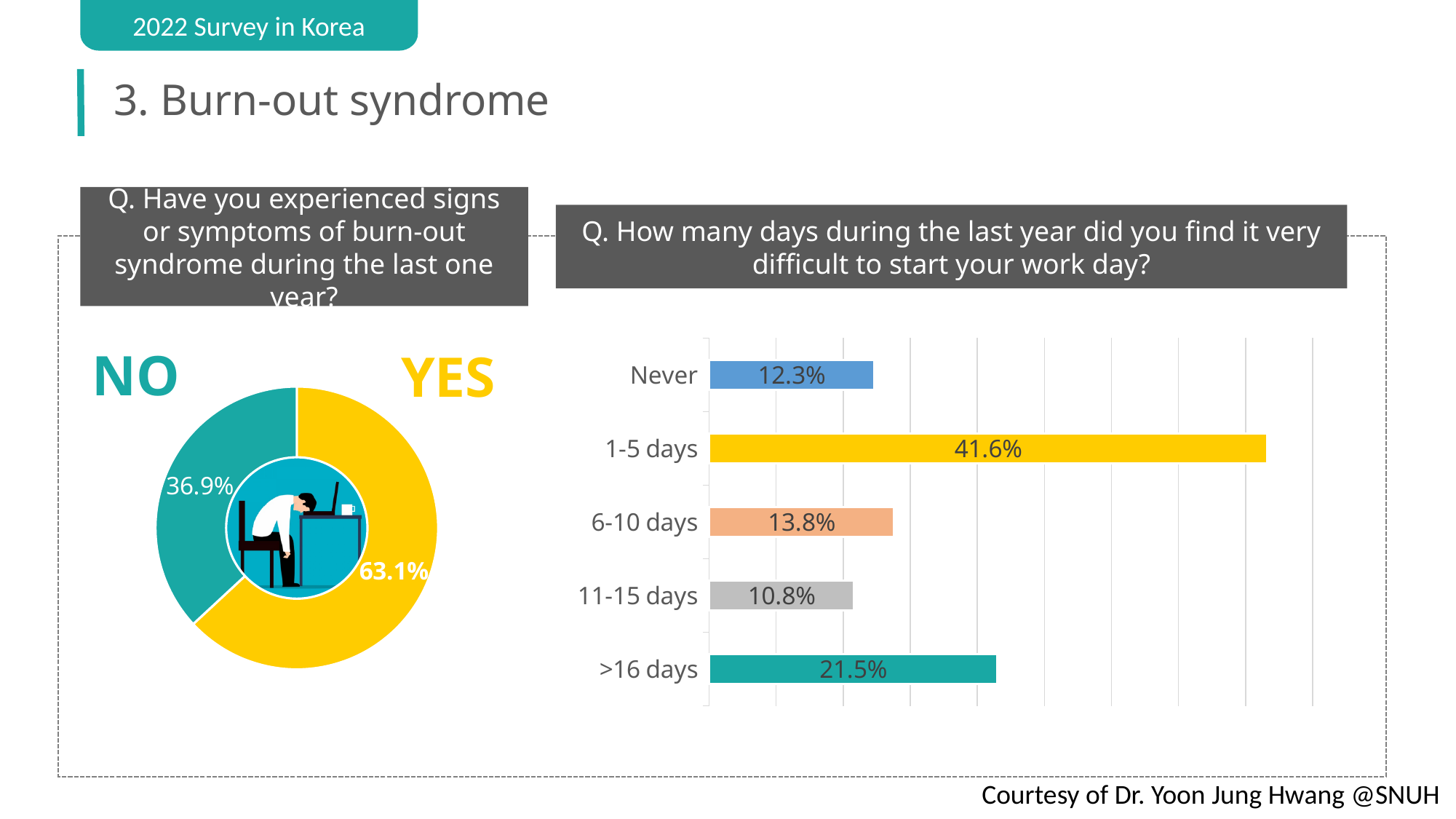
In the bar chart on the right, which category has the lowest value? 11-15 days In the bar chart on the right, which category has the highest value? 1-5 days In the bar chart on the right, which is larger, the value for Never or the value for >16 days? >16 days In the bar chart on the right, what is the difference between the values for 6-10 days and Never? 1.5% In the pie chart on the left, which answer has the larger share, YES or NO? YES In the pie chart on the left, what percentage of respondents answered YES? 63.1% What kind of chart is shown on the right side of the slide? Bar chart In the bar chart on the right, what is the value for >16 days? 21.5% How many categories are shown in the bar chart on the right? 5 In the pie chart on the left, what percentage of respondents answered NO? 36.9% In the pie chart on the left, what is the difference between the YES and NO shares? 26.2% In the bar chart on the right, what is the value for 1-5 days? 41.6%